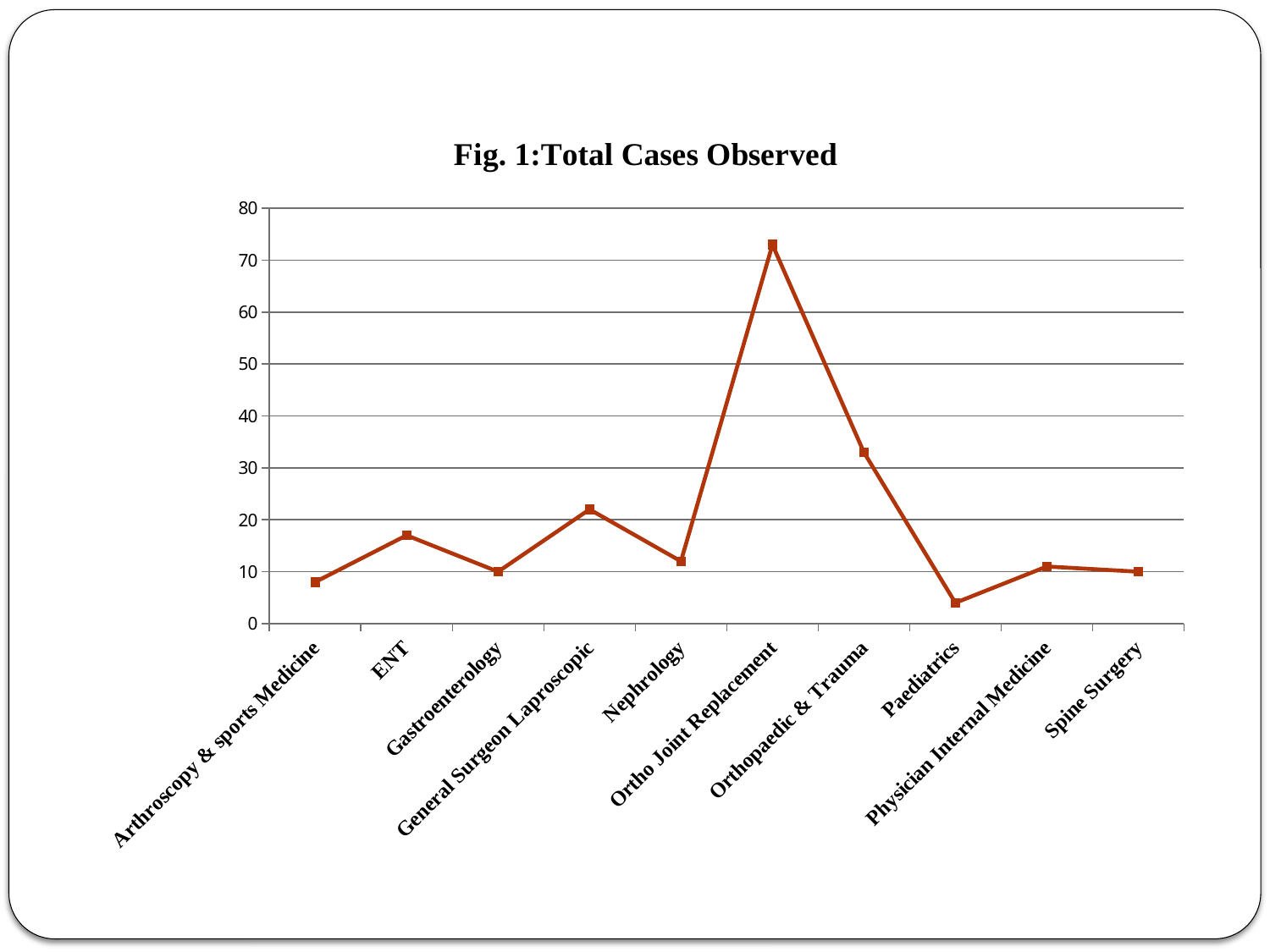
Which is larger, the value for ENT or the value for Nephrology? ENT Is the value for General Surgeon Laproscopic greater or less than 20? greater What is the title of the chart? Fig. 1:Total Cases Observed Is the value for Paediatrics greater or less than 10? less Is the value for Ortho Joint Replacement greater or less than 70? greater Does the line rise or fall from Ortho Joint Replacement to Paediatrics? fall Which is larger, the value for Orthopaedic & Trauma or the value for General Surgeon Laproscopic? Orthopaedic & Trauma How many categories are plotted along the x axis? 10 What kind of chart is shown on the slide? line chart Which category has the highest value? Ortho Joint Replacement Which category has the lowest value? Paediatrics